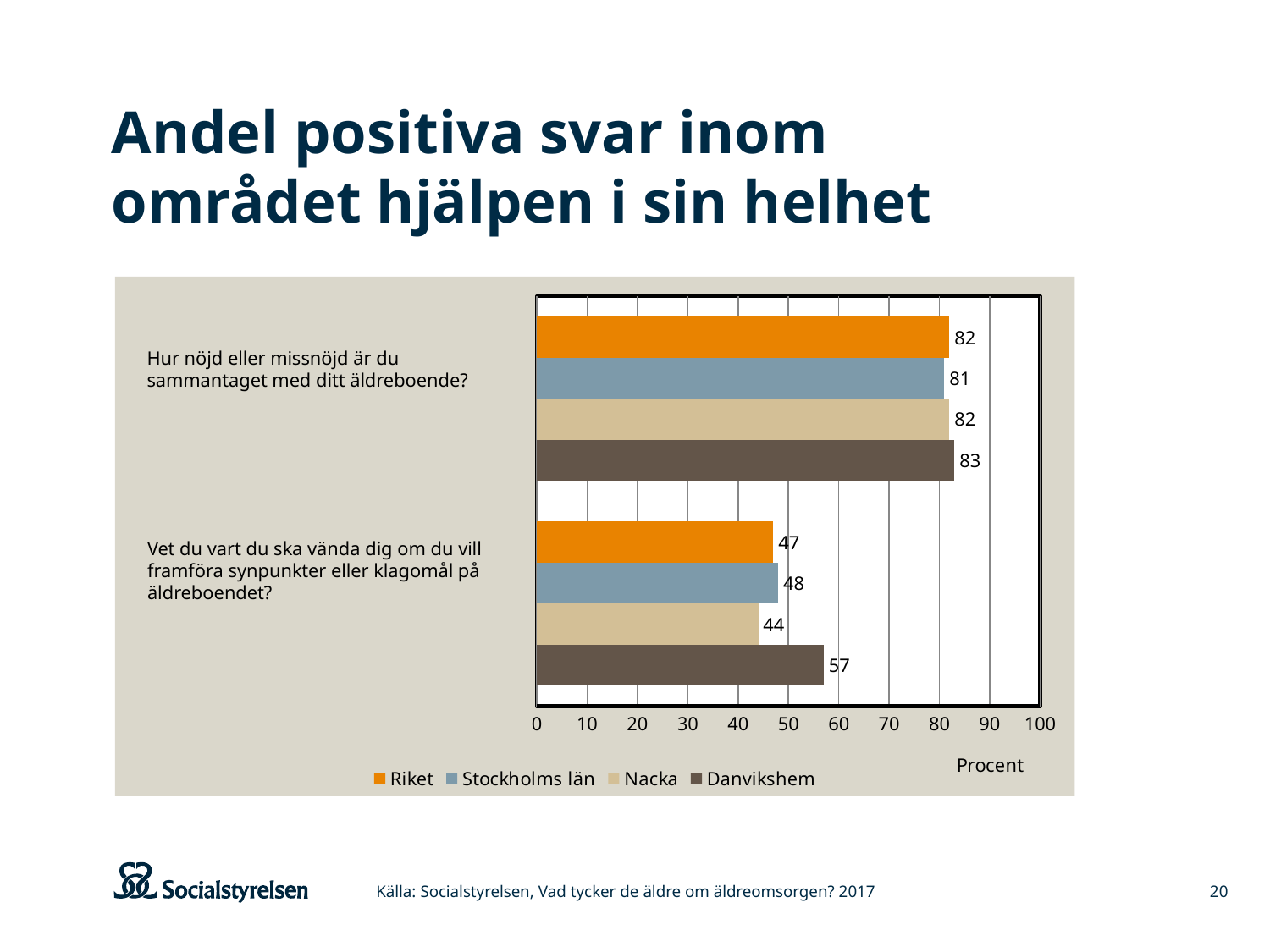
What is the value for Riket for the question "Vet du vart du ska vända dig om du vill framföra synpunkter eller klagomål på äldreboendet?"? 47 What is the value for Stockholms län for the question "Hur nöjd eller missnöjd är du sammantaget med ditt äldreboende?"? 81 What is the value for Danvikshem for the question "Hur nöjd eller missnöjd är du sammantaget med ditt äldreboende?"? 83 What is the value for Nacka for the question "Vet du vart du ska vända dig om du vill framföra synpunkter eller klagomål på äldreboendet?"? 44 What unit is shown on the x axis of the chart? Procent How many series does the legend list? 4 Which is larger for the question "Hur nöjd eller missnöjd är du sammantaget med ditt äldreboende?": the value for Danvikshem or the value for Stockholms län? Danvikshem Which series has the highest value for the question "Vet du vart du ska vända dig om du vill framföra synpunkter eller klagomål på äldreboendet?"? Danvikshem What kind of chart is shown on the slide? bar chart Which series has the lowest value for the question "Vet du vart du ska vända dig om du vill framföra synpunkter eller klagomål på äldreboendet?"? Nacka How many survey questions (categories) are shown on the chart? 2 What is the difference between the Danvikshem and Nacka values for the question "Vet du vart du ska vända dig om du vill framföra synpunkter eller klagomål på äldreboendet?"? 13